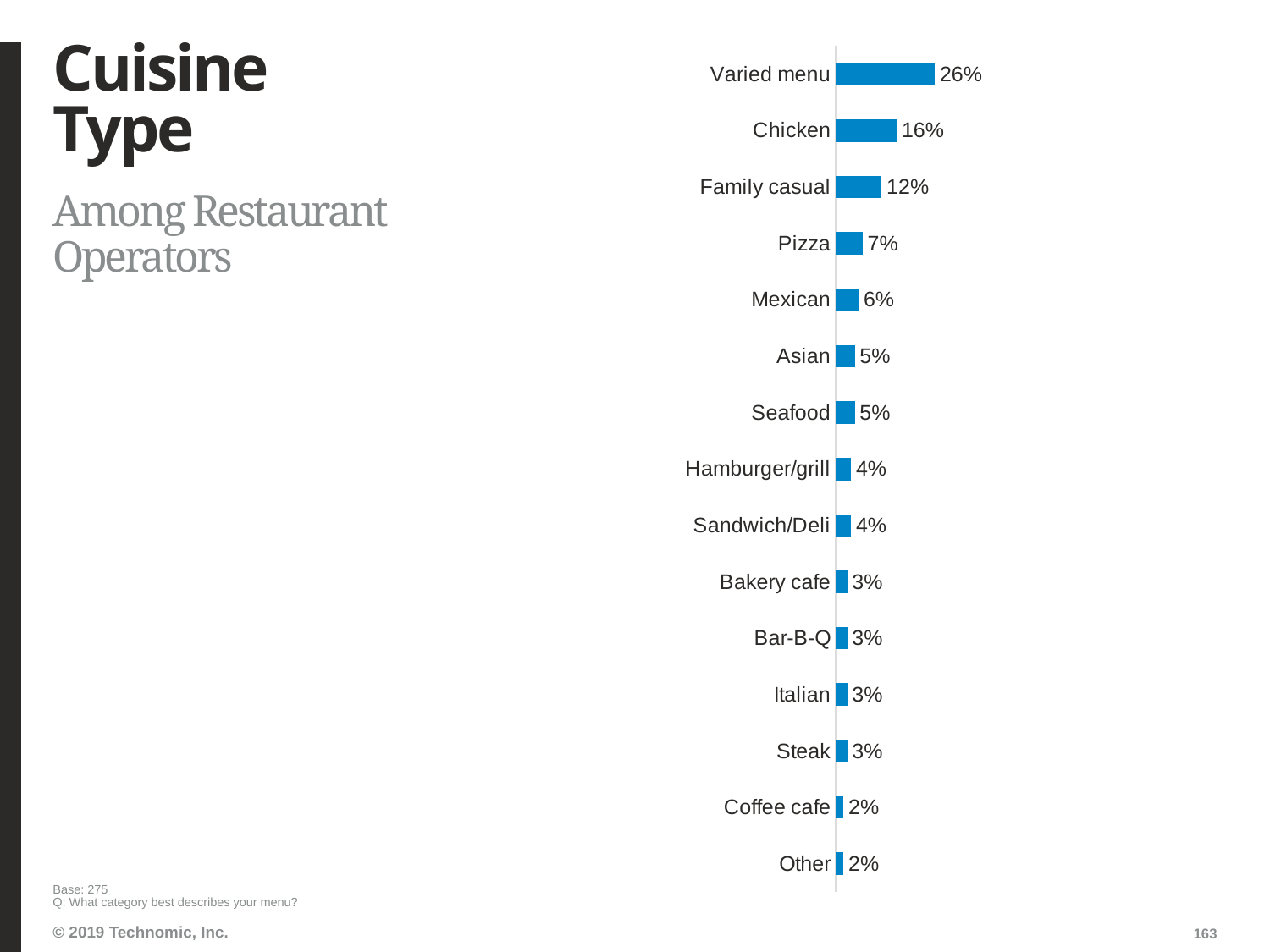
Which is larger, the value for Chicken or the value for Family casual? Chicken What is the value for Mexican? 6% What is the difference between the values for Varied menu and Chicken? 10% How many cuisine type categories are shown in the chart? 15 Which is larger, the value for Pizza or the value for Mexican? Pizza What is the value for Family casual? 12% Which cuisine type has the highest value? Varied menu What is the difference between the values for Family casual and Pizza? 5% What is the base (number of respondents) noted on the slide? 275 What percentage of restaurant operators describe their menu as Varied menu? 26% What kind of chart is shown on the slide? Bar chart What is the value for Chicken? 16%